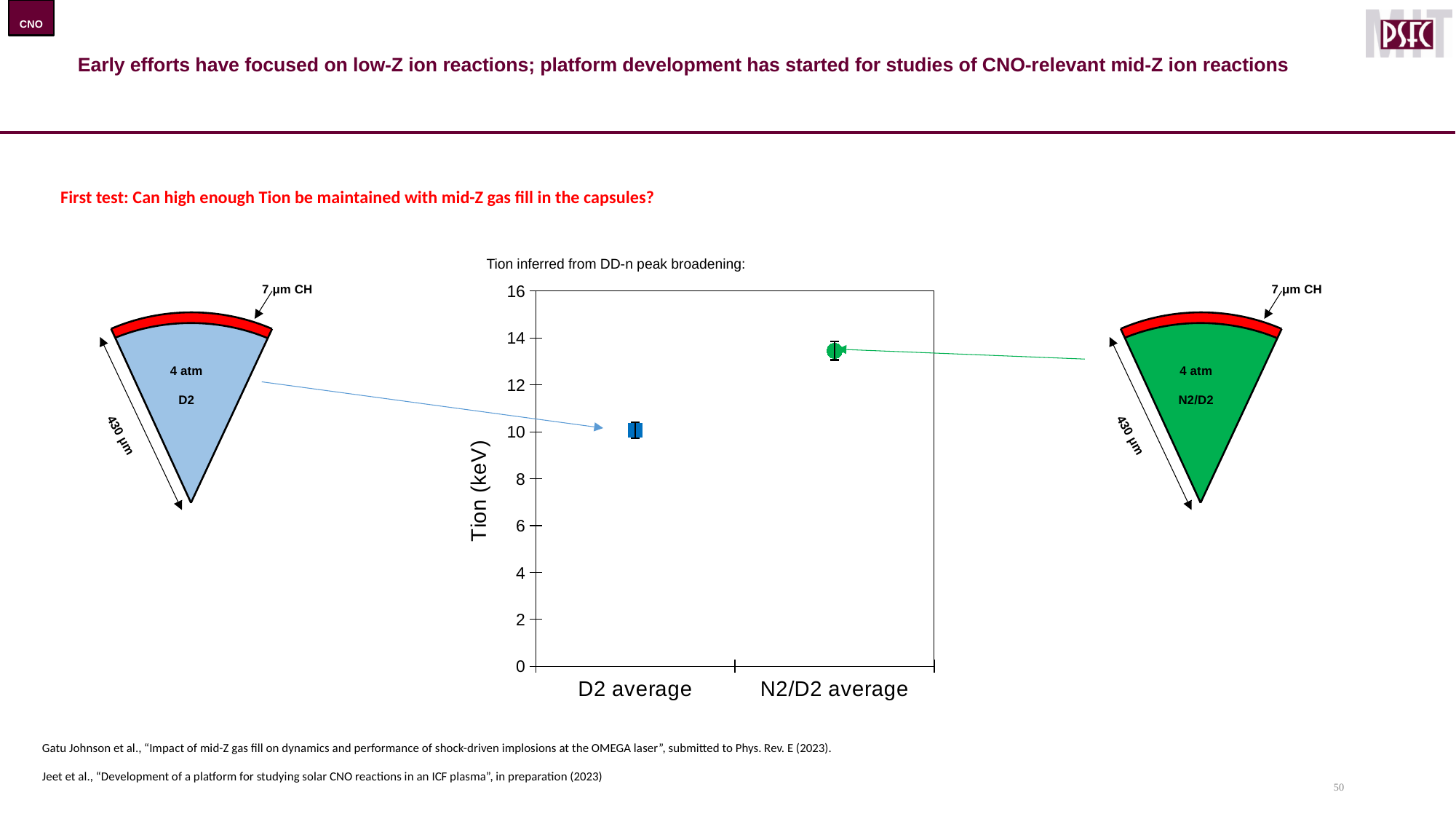
Do the plotted values rise or fall going from D2 average to N2/D2 average? rise Which category has the higher Tion value? N2/D2 average Is the Tion value for N2/D2 average greater or less than 16? less Is the Tion value for N2/D2 average greater or less than 12? greater Which category has the lower Tion value? D2 average What kind of chart is shown on the slide? scatter chart Which is larger, the Tion value for D2 average or for N2/D2 average? N2/D2 average Is the Tion value for D2 average greater or less than 8? greater What is the label of the y axis of the chart? Tion (keV) How many categories are plotted on the x axis of the chart? 2 What is the maximum value shown on the y axis of the chart? 16